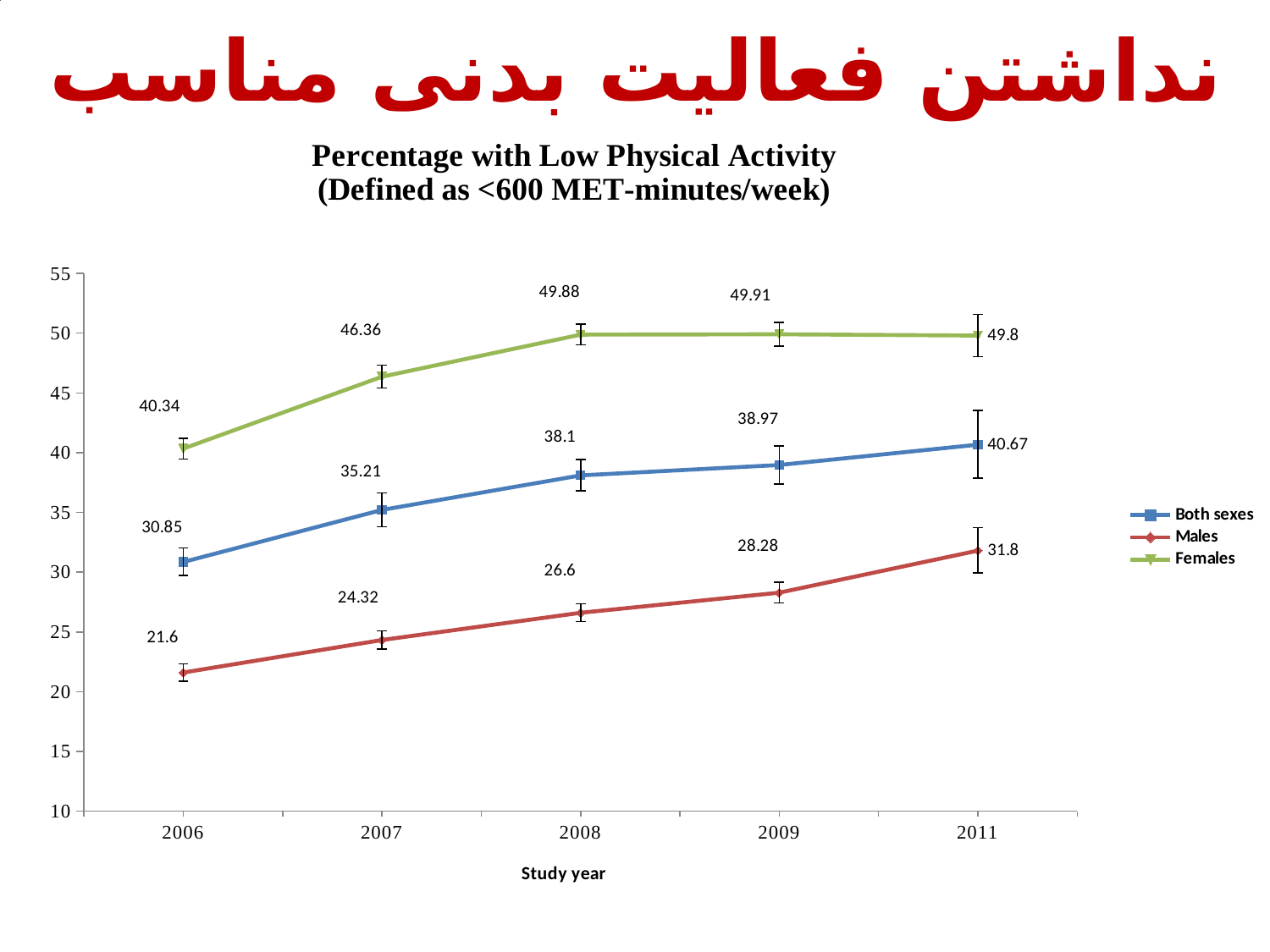
In which study year is the Males value highest? 2011 What kind of chart is shown? line chart What is the value for Males in 2006? 21.6 How many study years are plotted on the x axis? 5 What is the difference between the Females and Males values in 2011? 18 What is the label of the x axis? Study year Which is larger in 2007: the Females value or the Both sexes value? Females Do the Males values rise or fall from 2006 to 2011? rise What is the value for Females in 2008? 49.88 In which study year is the Both sexes value lowest? 2006 How many series does the legend list? 3 What is the value for Both sexes in 2011? 40.67